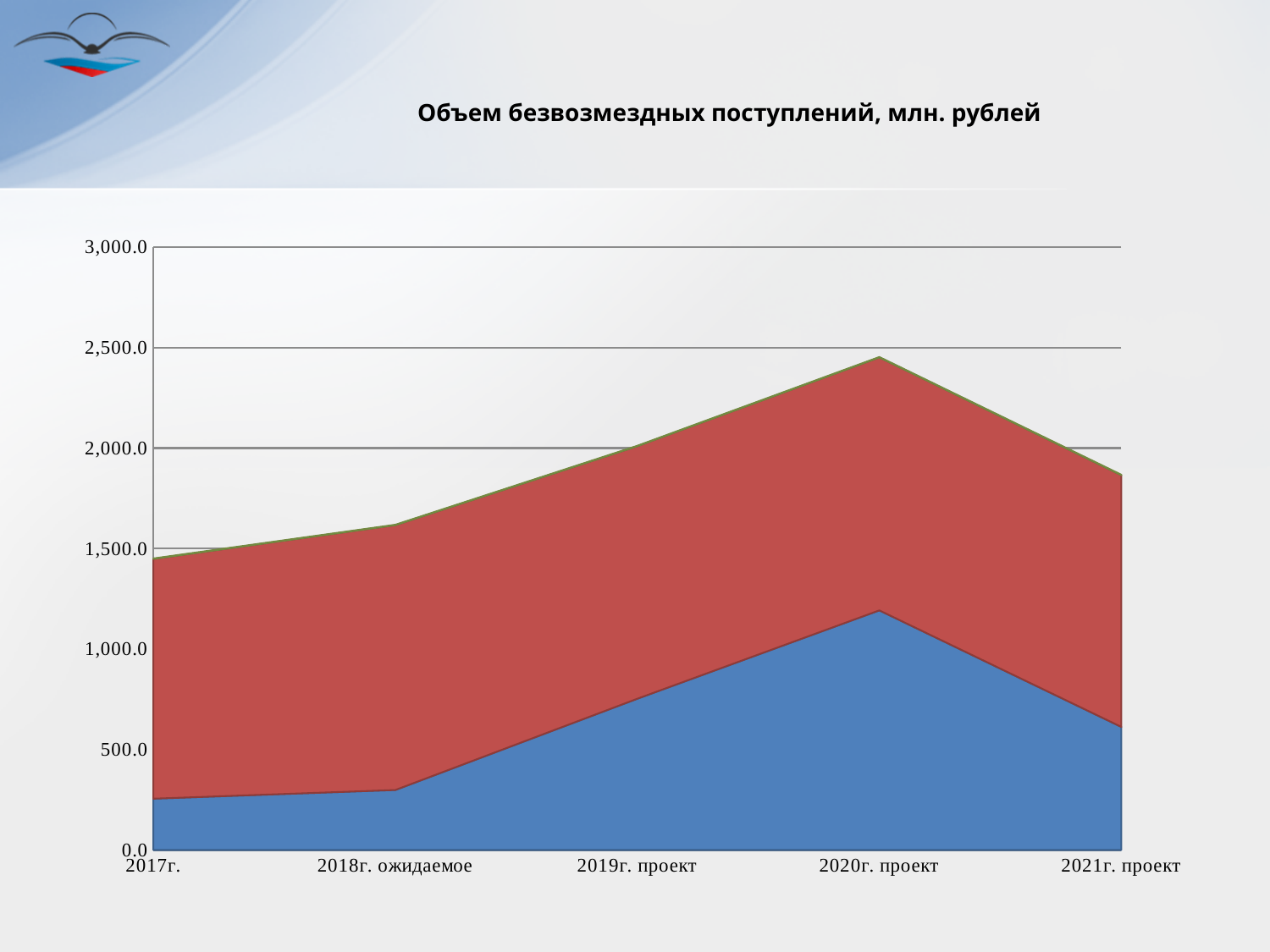
What kind of chart is shown on the slide? Area chart In which category is the blue series lowest? 2017г. How many categories are shown along the x axis? 5 Is the value of the blue series for 2020г. проект greater or less than 1,000.0? greater Is the value of the blue series for 2017г. greater or less than 500.0? less Which is larger for the blue series: the value for 2019г. проект or the value for 2018г. ожидаемое? 2019г. проект In which category does the blue series reach its highest value? 2020г. проект Does the blue series rise or fall from 2020г. проект to 2021г. проект? fall What is the title of the chart? Объем безвозмездных поступлений, млн. рублей In which category is the total height of the stacked areas highest? 2020г. проект Is the total of the stacked areas for 2021г. проект greater or less than 2,000.0? less How many coloured series are stacked in the chart? 3